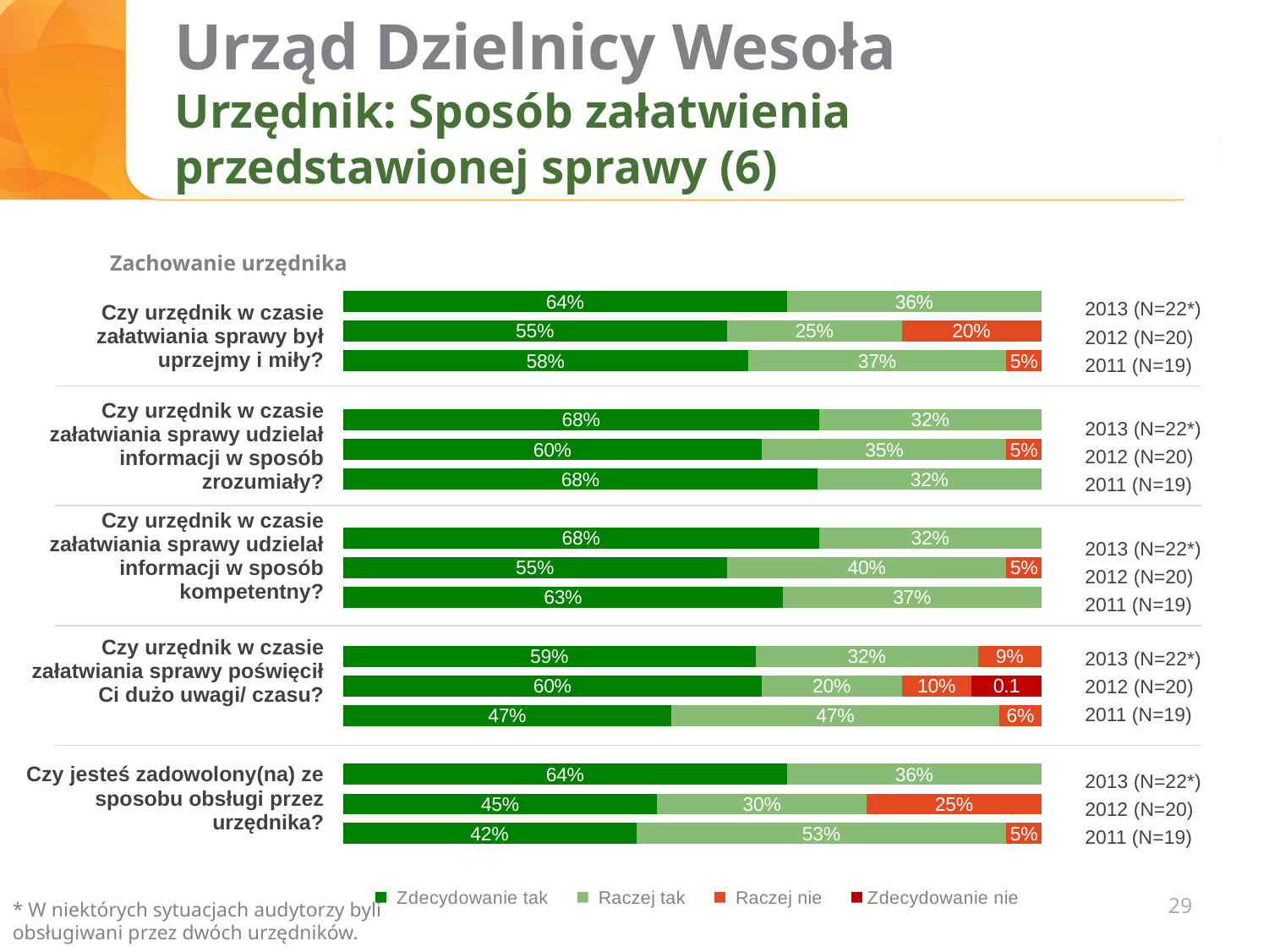
What percentage answered "Zdecydowanie tak" in 2013 to "Czy urzędnik w czasie załatwiania sprawy był uprzejmy i miły?"? 64% What percentage answered "Raczej nie" in 2012 to "Czy urzędnik w czasie załatwiania sprawy był uprzejmy i miły?"? 20% What percentage answered "Raczej nie" in 2013 to "Czy urzędnik w czasie załatwiania sprawy poświęcił Ci dużo uwagi/ czasu?"? 9% What percentage answered "Raczej tak" in 2012 to "Czy urzędnik w czasie załatwiania sprawy udzielał informacji w sposób kompetentny?"? 40% How many answer categories does the legend list? 4 What percentage answered "Raczej tak" in 2011 to "Czy jesteś zadowolony(na) ze sposobu obsługi przez urzędnika?"? 53% For "Czy jesteś zadowolony(na) ze sposobu obsługi przez urzędnika?", by how many percentage points did the "Zdecydowanie tak" share change from 2012 to 2013? 19 percentage points What percentage answered "Zdecydowanie tak" in 2011 to "Czy jesteś zadowolony(na) ze sposobu obsługi przez urzędnika?"? 42% What kind of chart is shown on the slide? Stacked bar chart For "Czy urzędnik w czasie załatwiania sprawy poświęcił Ci dużo uwagi/ czasu?", which year had the larger "Zdecydowanie tak" share, 2013 or 2011? 2013 How many years are shown for each question? 3 For "Czy urzędnik w czasie załatwiania sprawy udzielał informacji w sposób zrozumiały?", which year had the lowest "Zdecydowanie tak" share? 2012